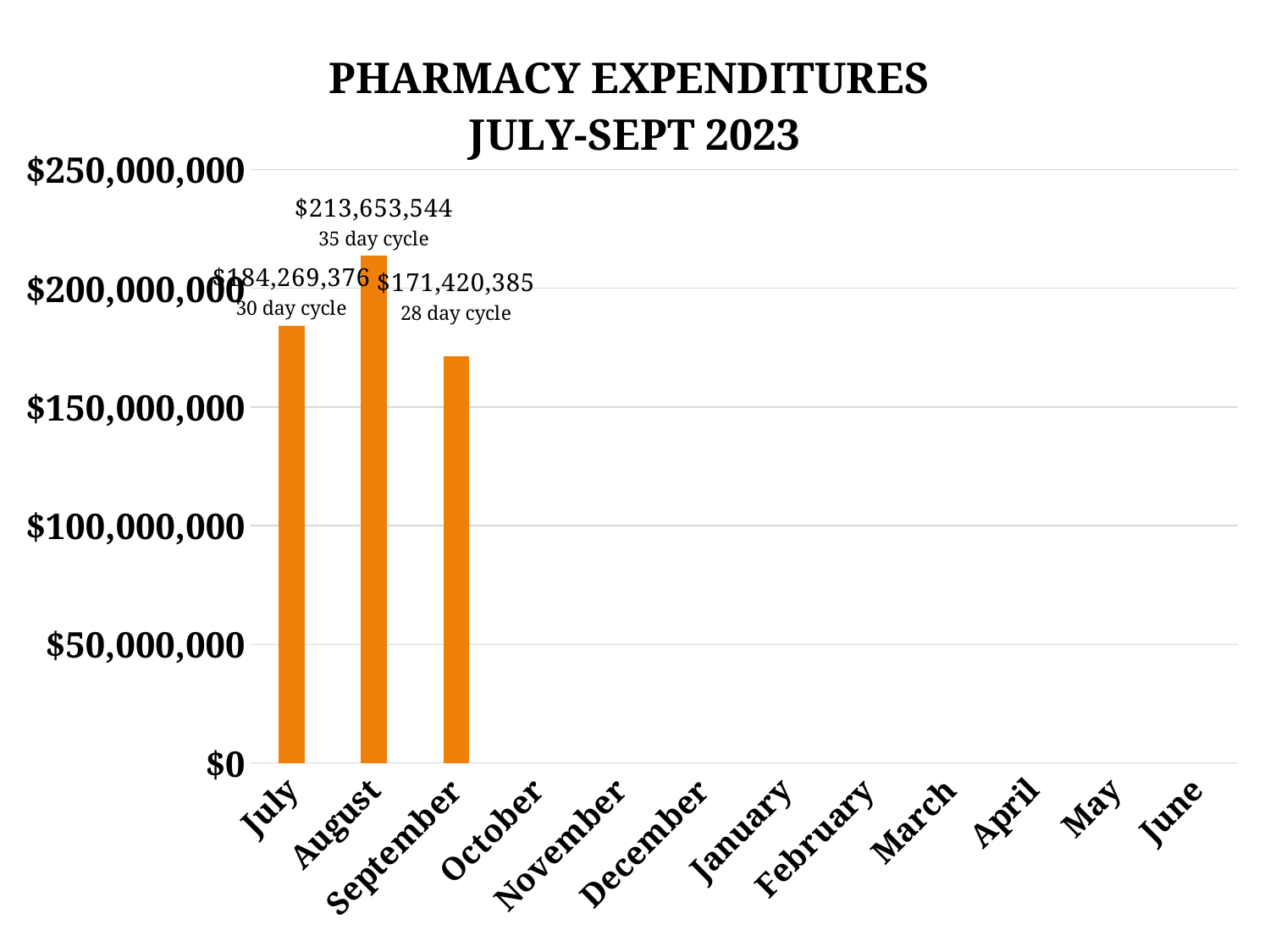
Which of the months with a plotted bar has the lowest pharmacy expenditure? September What is the difference between the August and July expenditures? $29,384,168 What is the pharmacy expenditure for August? $213,653,544 What is the pharmacy expenditure for September? $171,420,385 Which month has the highest pharmacy expenditure? August What kind of chart is shown on the slide? Bar chart Which is larger, the expenditure for July or for September? July How many days is the billing cycle noted for August? 35 day cycle How many months have a bar plotted on the chart? 3 What is the difference between the July and September expenditures? $12,848,991 Is the value for August greater or less than $200,000,000? greater What is the pharmacy expenditure for July? $184,269,376